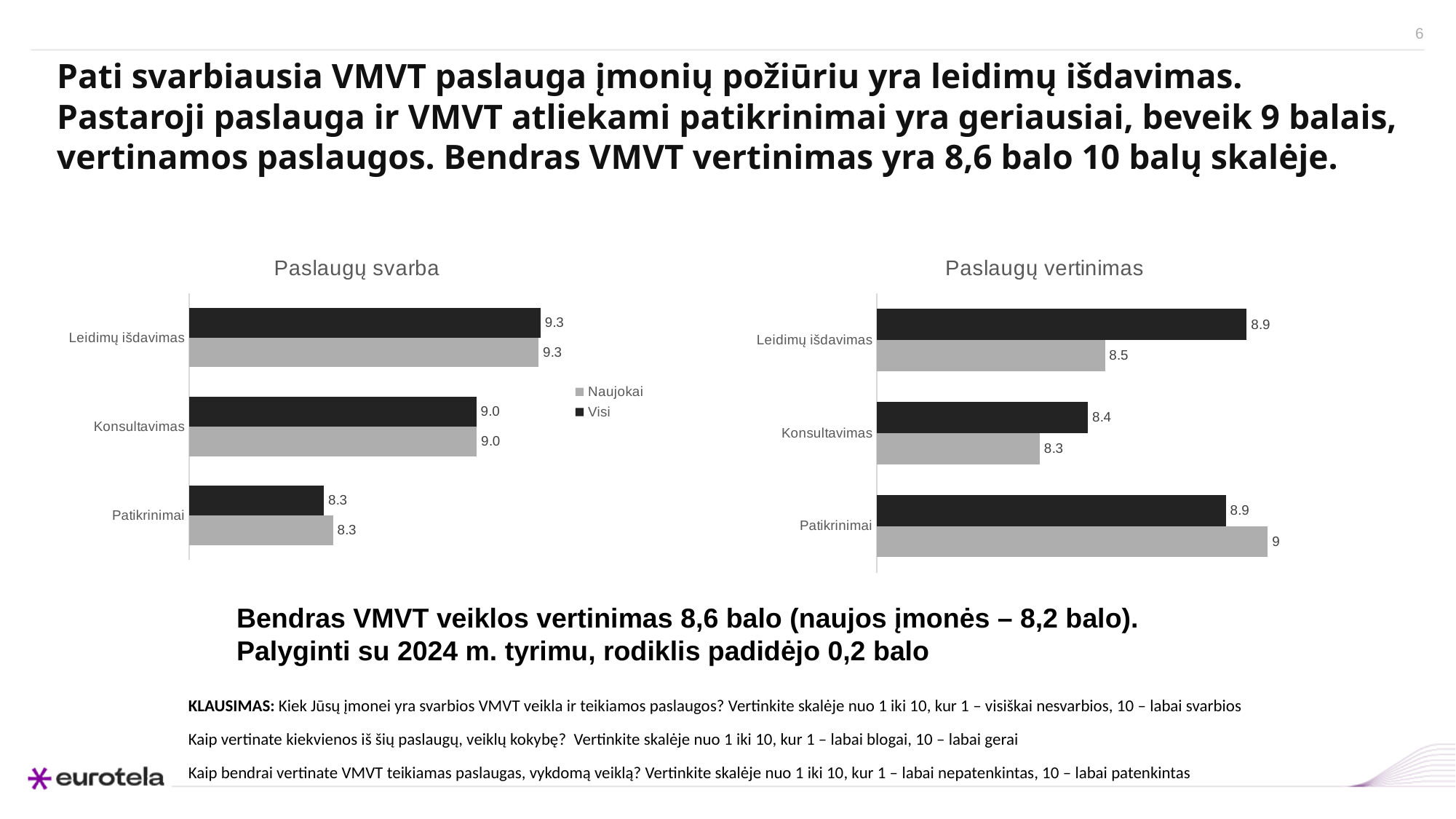
How many categories are shown in the 'Paslaugų vertinimas' chart? 3 In the 'Paslaugų vertinimas' chart, what is the difference between the black (Visi) bar and the grey (Naujokai) bar for Leidimų išdavimas? 0.4 In the 'Paslaugų vertinimas' chart, for Patikrinimai, which bar is larger: the black (Visi) bar or the grey (Naujokai) bar? Grey (Naujokai) In the 'Paslaugų svarba' chart, which category has the lowest value in the Visi series? Patikrinimai In the 'Paslaugų svarba' chart, what is the value for Leidimų išdavimas in the Visi series? 9.3 In the 'Paslaugų vertinimas' chart, what is the value of the black (Visi) bar for Konsultavimas? 8.4 In the 'Paslaugų svarba' chart, which category has the highest value in the Naujokai series? Leidimų išdavimas In the 'Paslaugų vertinimas' chart, what is the value of the grey (Naujokai) bar for Patikrinimai? 9 How many series does the legend on the slide list? 2 In the 'Paslaugų svarba' chart, what is the difference between the Visi values for Leidimų išdavimas and Patikrinimai? 1.0 What type of chart is the 'Paslaugų svarba' chart? Bar chart In the 'Paslaugų svarba' chart, what is the value for Patikrinimai in the Naujokai series? 8.3